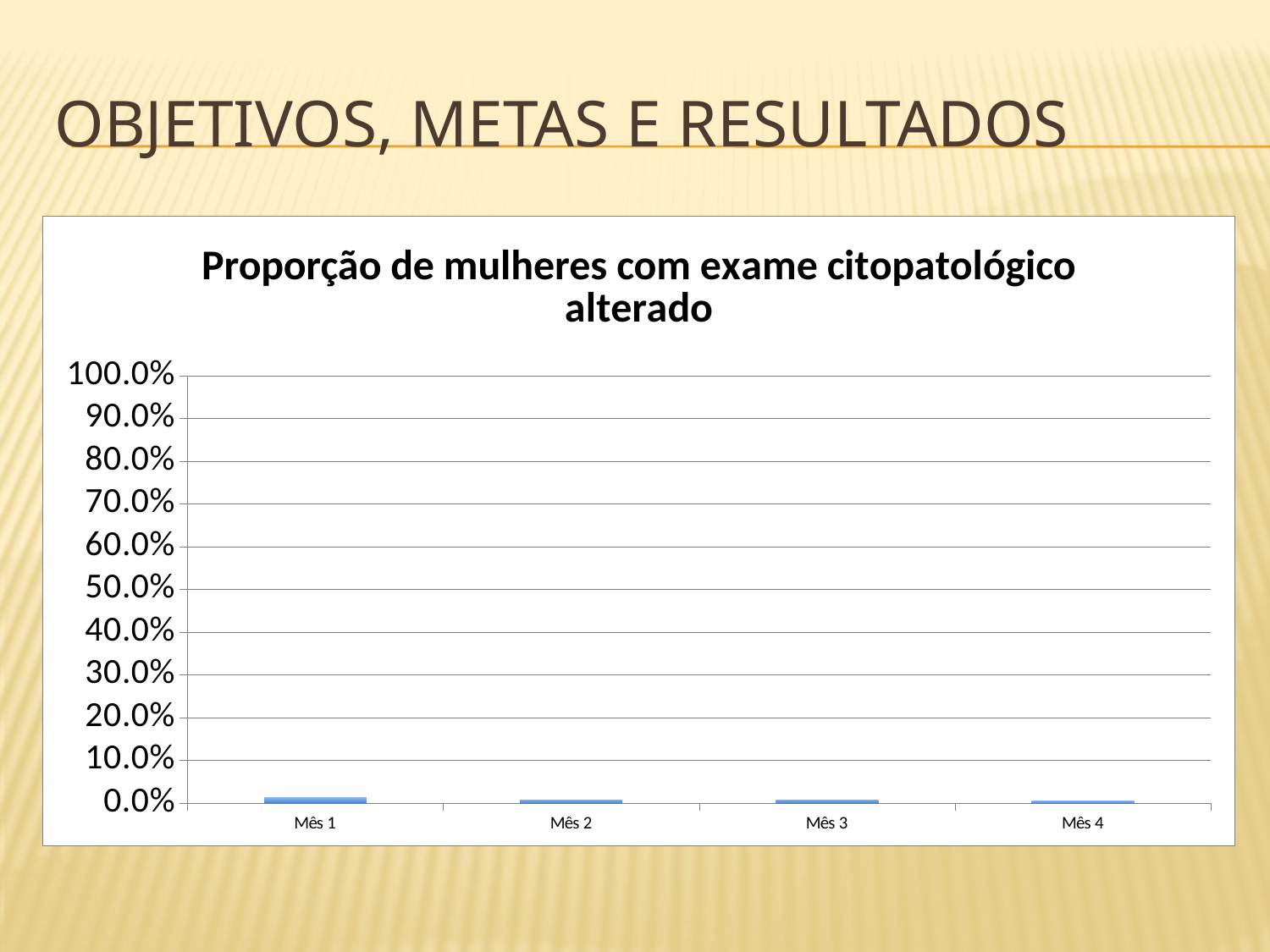
Is the value for Mês 2 greater or less than 10.0%? less Is the value for Mês 1 greater or less than 10.0%? less Is the value for Mês 1 greater or less than 20.0%? less How many categories are plotted on the x axis of the chart? 4 What is the highest value shown on the y axis of the chart? 100.0% What kind of chart is shown on the slide? bar chart What is the title of the chart? Proporção de mulheres com exame citopatológico alterado